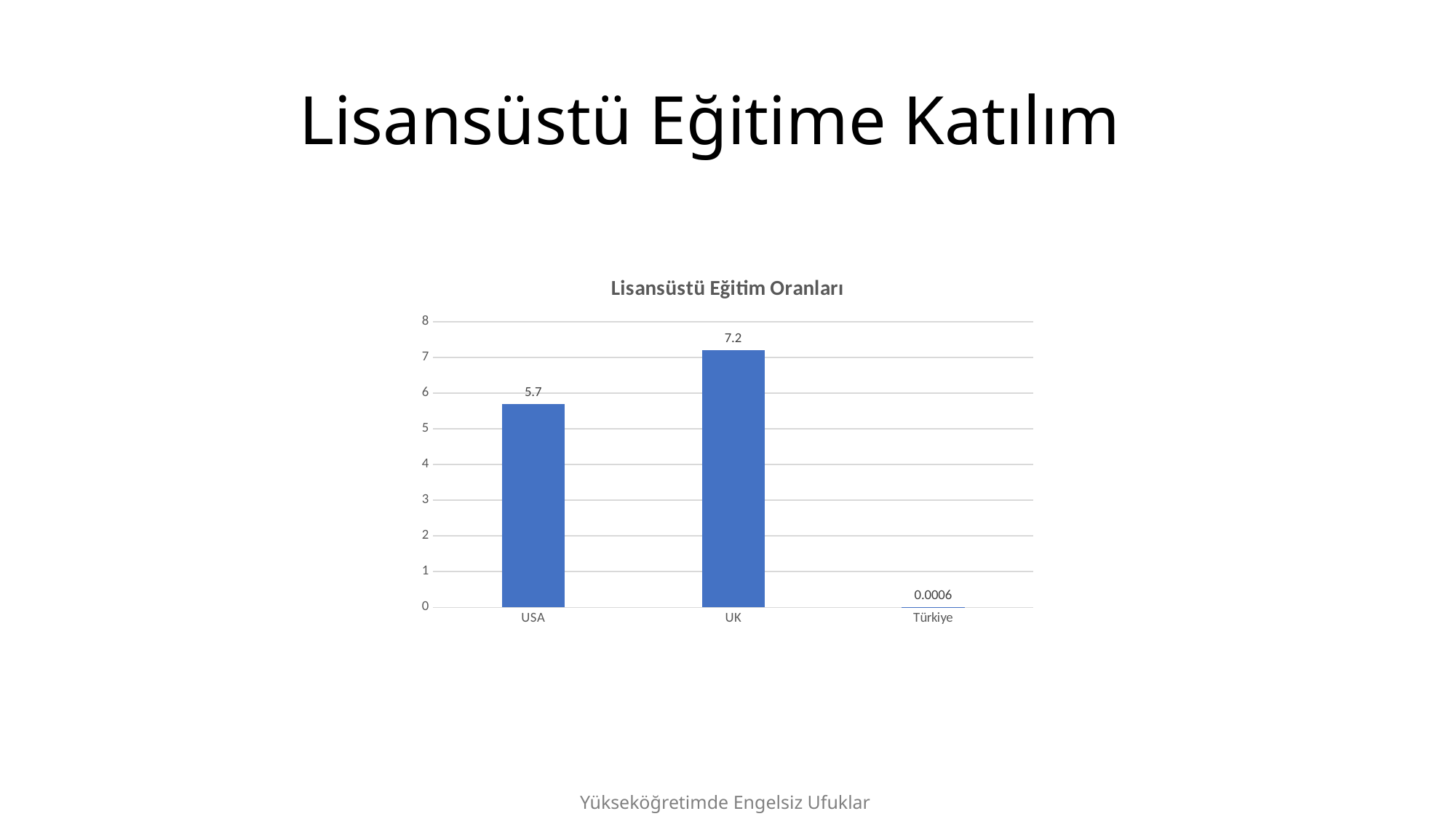
What is the title of the chart? Lisansüstü Eğitim Oranları What kind of chart is shown on the slide? bar chart What is the value for UK? 7.2 What is the value for Türkiye? 0.0006 How many categories are shown in the chart? 3 Is the value for USA greater or less than 5? greater Which category has the lowest value? Türkiye Which category has the highest value? UK What is the difference between the values for UK and USA? 1.5 What is the highest value shown on the vertical axis? 8 Which is larger, the value for USA or the value for UK? UK What is the value for USA? 5.7